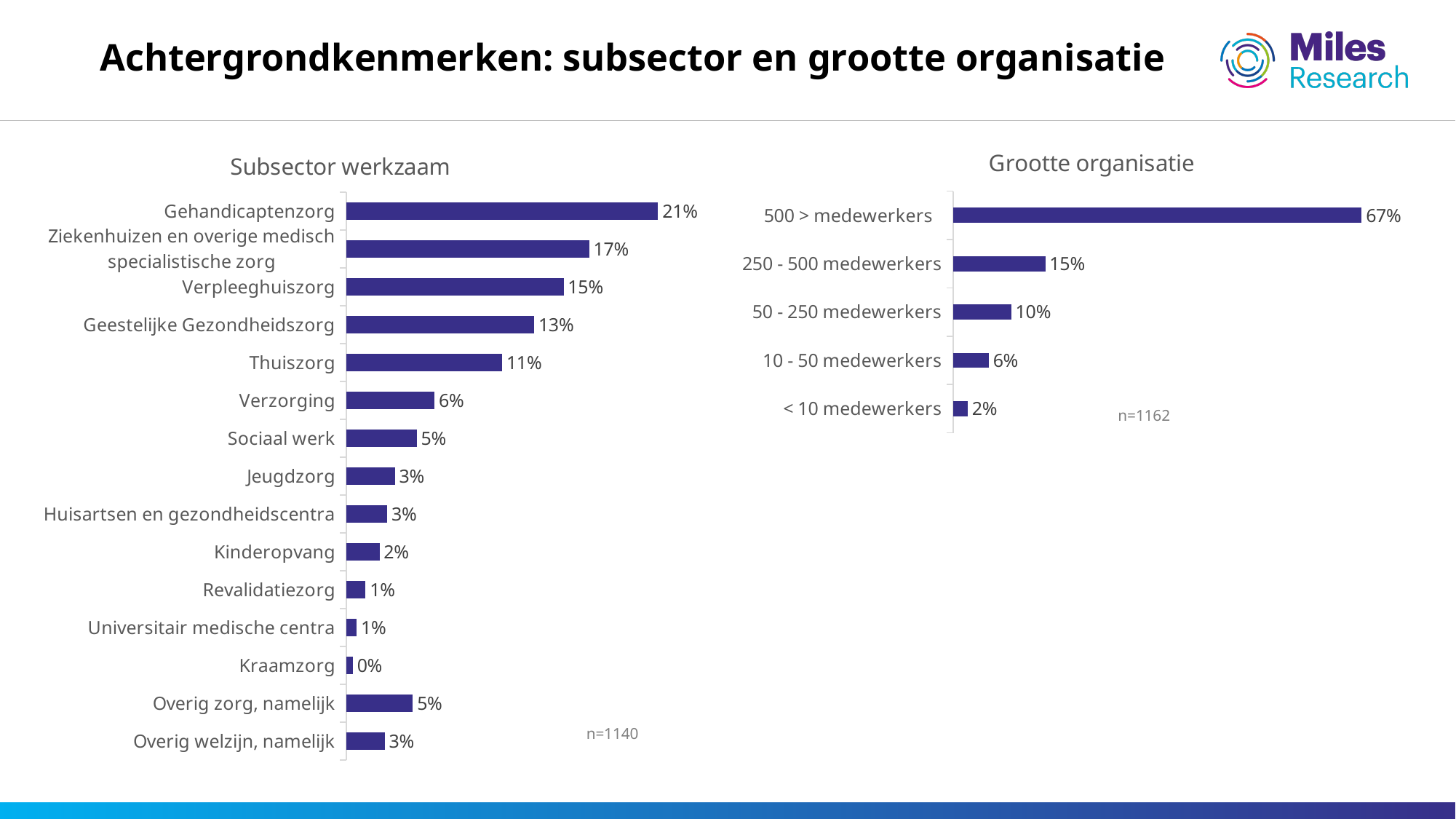
How many categories are shown in the 'Grootte organisatie' chart? 5 In the 'Subsector werkzaam' chart, which category has the highest value? Gehandicaptenzorg In the 'Subsector werkzaam' chart, what is the value for Thuiszorg? 11% How many categories are shown in the 'Subsector werkzaam' chart? 15 In the 'Grootte organisatie' chart, which category has the highest value? 500 > medewerkers What type of chart is the 'Grootte organisatie' chart? Bar chart In the 'Grootte organisatie' chart, what is the value for 250 - 500 medewerkers? 15% In the 'Subsector werkzaam' chart, which is larger: Verzorging or Sociaal werk? Verzorging In the 'Subsector werkzaam' chart, which category has the lowest value? Kraamzorg In the 'Subsector werkzaam' chart, what is the value for Gehandicaptenzorg? 21% In the 'Grootte organisatie' chart, what is the difference between 500 > medewerkers and 50 - 250 medewerkers? 57% In the 'Subsector werkzaam' chart, what is the difference between Verpleeghuiszorg and Geestelijke Gezondheidszorg? 2%